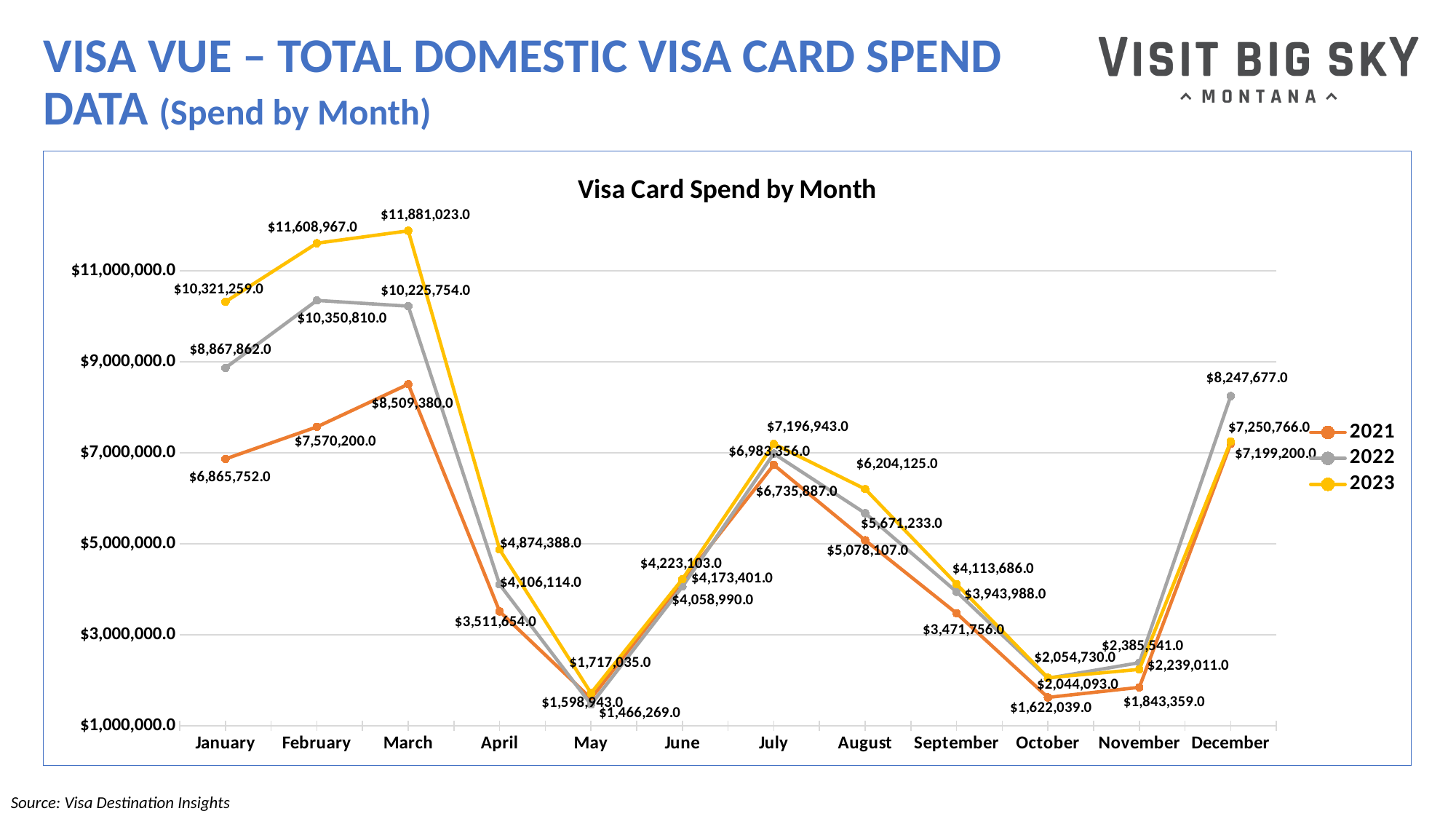
Which month has the highest 2022 value? February What is the difference between the 2022 and 2021 values for December? $1,048,477.0 What is the 2021 value for January? $6,865,752.0 Which month has the highest 2023 value? March What is the 2022 value for December? $8,247,677.0 How many months are shown on the x axis? 12 What kind of chart is this? Line chart What is the 2023 value for March? $11,881,023.0 How many series does the legend list? 3 What is the difference between the 2023 values for March and February? $272,056.0 Which is larger in January, the 2022 value or the 2021 value? 2022 What is the 2023 value for August? $6,204,125.0